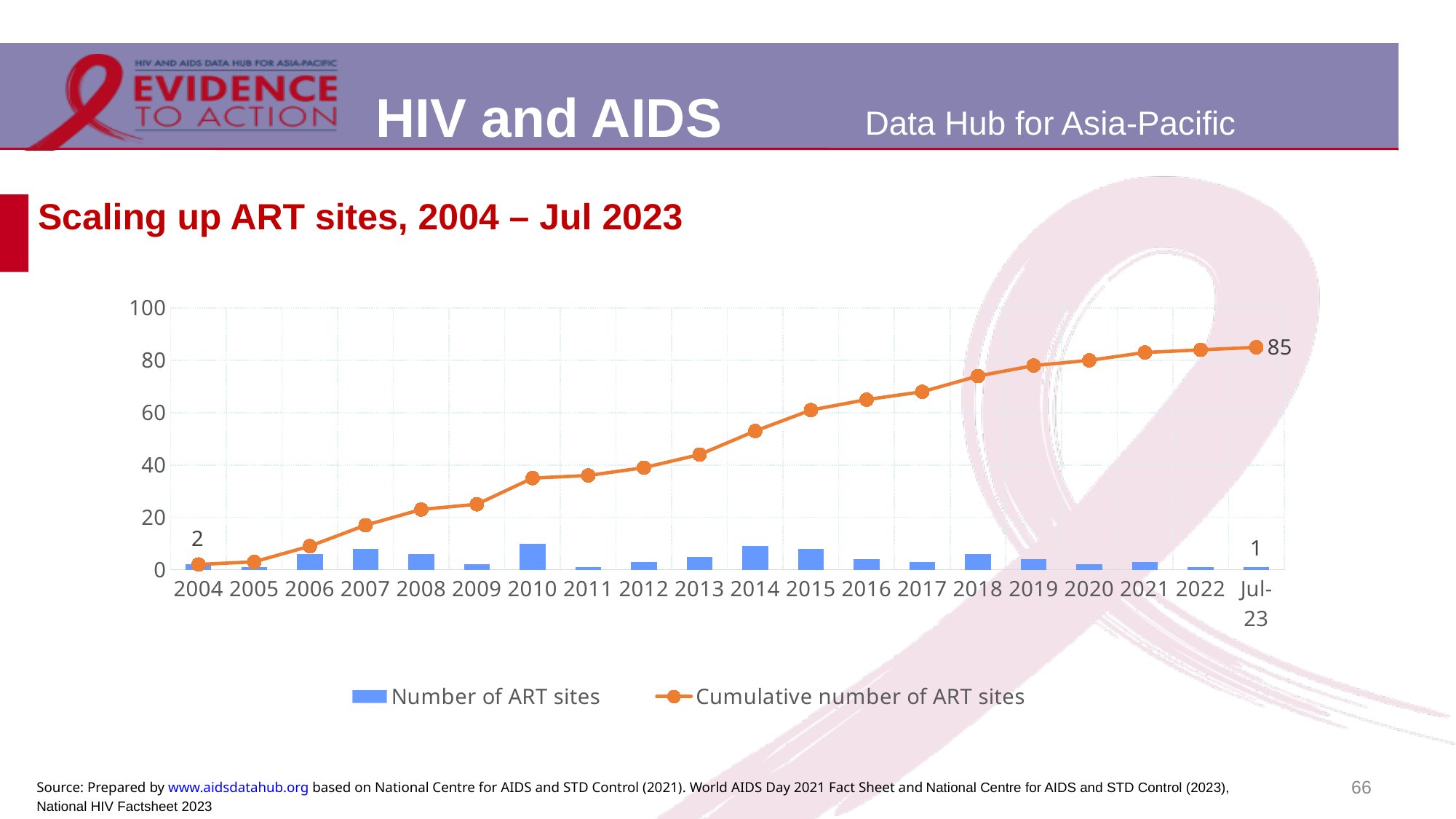
Which is larger, the cumulative number of ART sites in 2012 or in 2016? 2016 What is the cumulative number of ART sites in Jul-23? 85 What is the number of ART sites in 2004? 2 What is the title of the chart? Scaling up ART sites, 2004 – Jul 2023 What is the number of ART sites in Jul-23? 1 Does the cumulative number of ART sites rise or fall from 2004 to Jul-23? Rise How many time periods are shown on the x axis? 20 Is the cumulative number of ART sites in 2006 greater or less than 20? less What kind of chart is this? Combination bar and line chart Is the cumulative number of ART sites in 2010 greater or less than 20? greater Which period has the highest cumulative number of ART sites? Jul-23 How many series does the legend list? 2